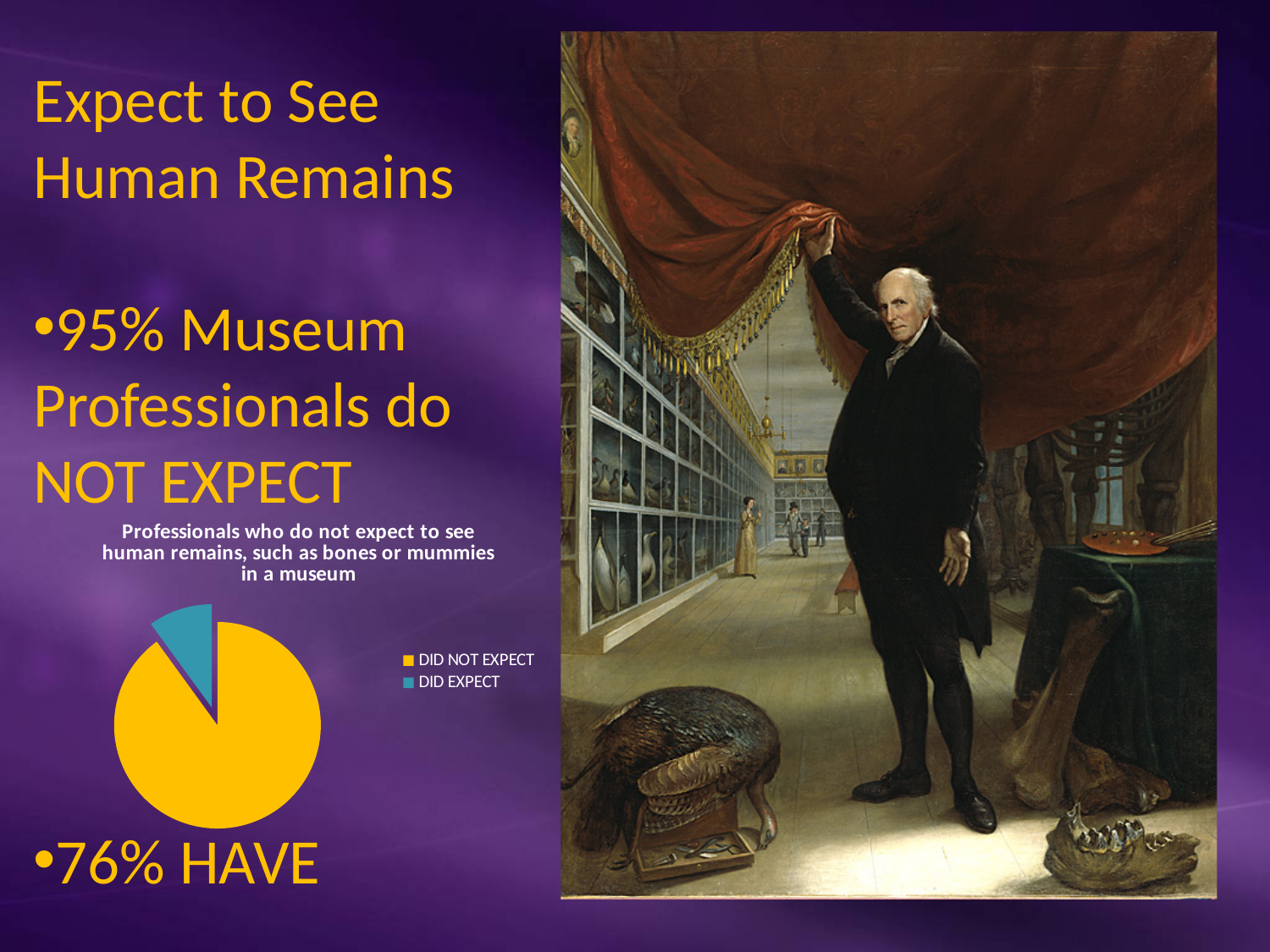
Which slice of the pie chart is the largest? DID NOT EXPECT What colour represents DID NOT EXPECT in the pie chart? Yellow Does the DID NOT EXPECT slice take up more or less than half of the pie chart? More How many slices does the pie chart have? 2 Which slice of the pie chart is the smallest? DID EXPECT Which legend entry in the pie chart is shown in teal? DID EXPECT What is the title of the pie chart? Professionals who do not expect to see human remains, such as bones or mummies in a museum What kind of chart is shown on the slide? Pie chart How many entries does the pie chart's legend list? 2 In the pie chart, which is larger: DID NOT EXPECT or DID EXPECT? DID NOT EXPECT